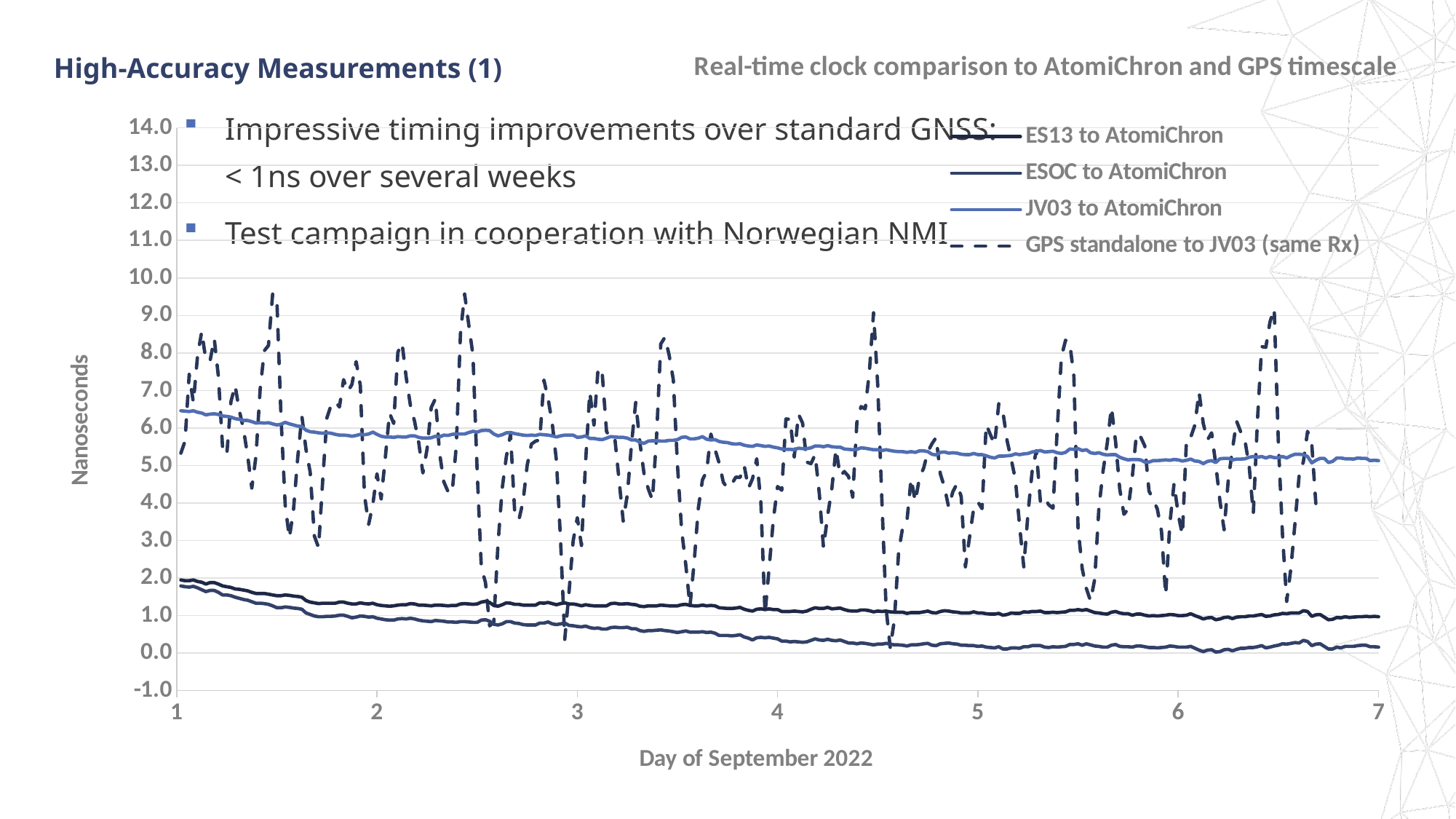
Does the ESOC to AtomiChron series rise or fall from day 1 to day 7? fall Which of the three solid-line series has the highest values across the chart? JV03 to AtomiChron Is the value for JV03 to AtomiChron at day 7 greater or less than 6.0? less What is the label of the x axis of the chart? Day of September 2022 At day 4, which is higher: JV03 to AtomiChron or ESOC to AtomiChron? JV03 to AtomiChron Is the value for JV03 to AtomiChron at day 1 greater or less than 6.0? greater Is the value for ES13 to AtomiChron at day 1 greater or less than 1.0? greater What kind of chart is shown on the slide? line chart What is the title of the chart? Real-time clock comparison to AtomiChron and GPS timescale How many series does the chart legend list? 4 Does the JV03 to AtomiChron series rise or fall from day 1 to day 7? fall